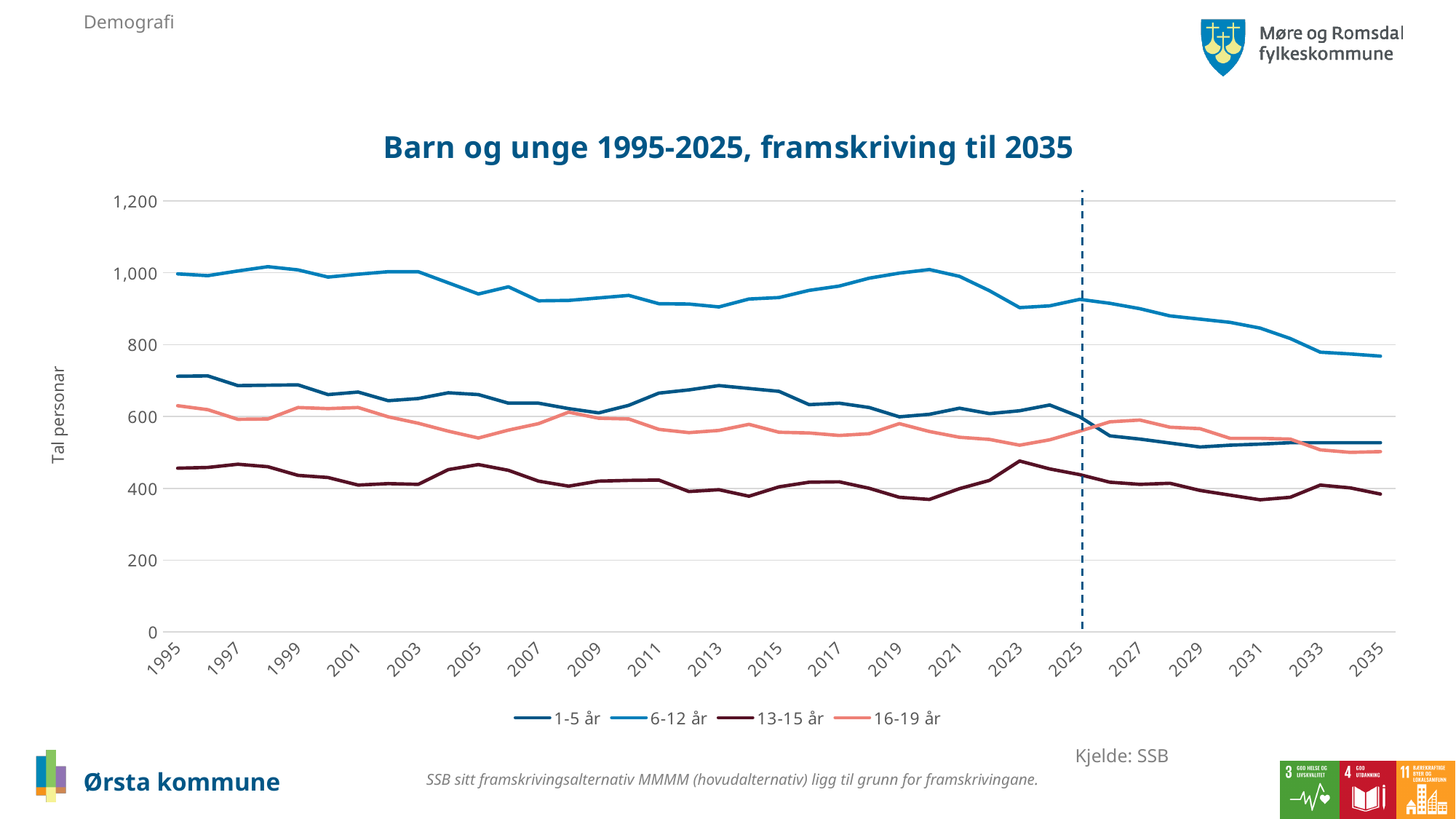
Which series has the highest values across the whole period? 6-12 år Does the 6-12 år series rise or fall between 2025 and 2035? fall In 2025, which is larger: the value for 6-12 år or the value for 13-15 år? 6-12 år Is the value for 6-12 år in 1995 greater or less than 800? greater What is the title of the chart? Barn og unge 1995-2025, framskriving til 2035 Which series has the lowest values across the whole period? 13-15 år Is the value for 16-19 år in 2035 greater or less than 600? less Is the value for 1-5 år in 1995 greater or less than 600? greater What kind of chart is shown on the slide? line chart What is the label on the vertical axis? Tal personar How many series does the legend list? 4